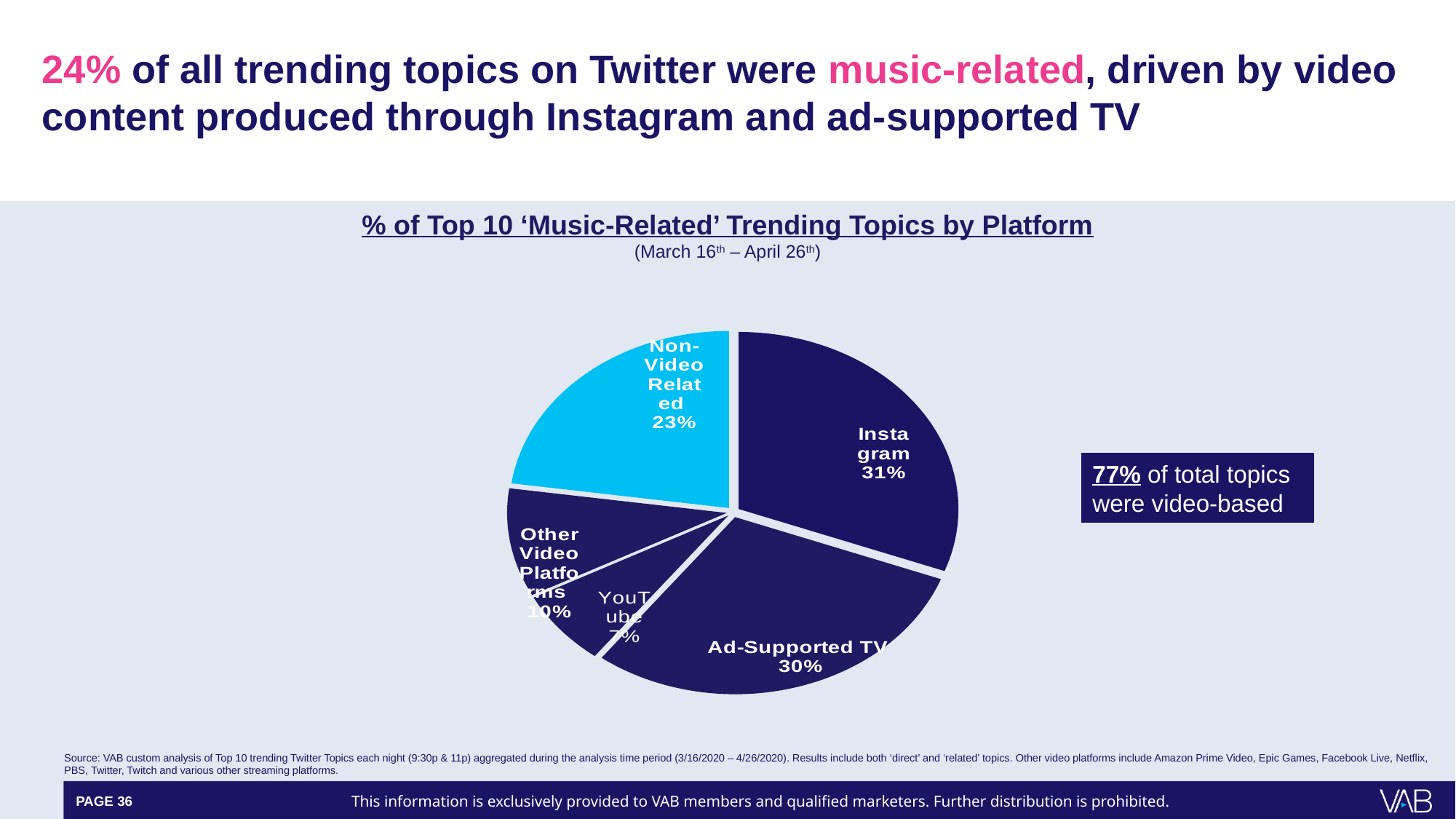
What percentage of the pie do Other Video Platforms account for? 10% What percentage of the pie does Ad-Supported TV account for? 30% What percentage of the pie is Non-Video Related? 23% Which slice of the pie is the smallest? YouTube What percentage of the pie does YouTube account for? 7% How many slices does the pie chart have? 5 What type of chart is shown on the slide? pie chart Which platform has the largest share of the pie? Instagram What is the title of the chart? % of Top 10 'Music-Related' Trending Topics by Platform What percentage of the pie does Instagram account for? 31% What is the difference in percentage points between Non-Video Related and Other Video Platforms? 13 Which slice is larger, Other Video Platforms or YouTube? Other Video Platforms